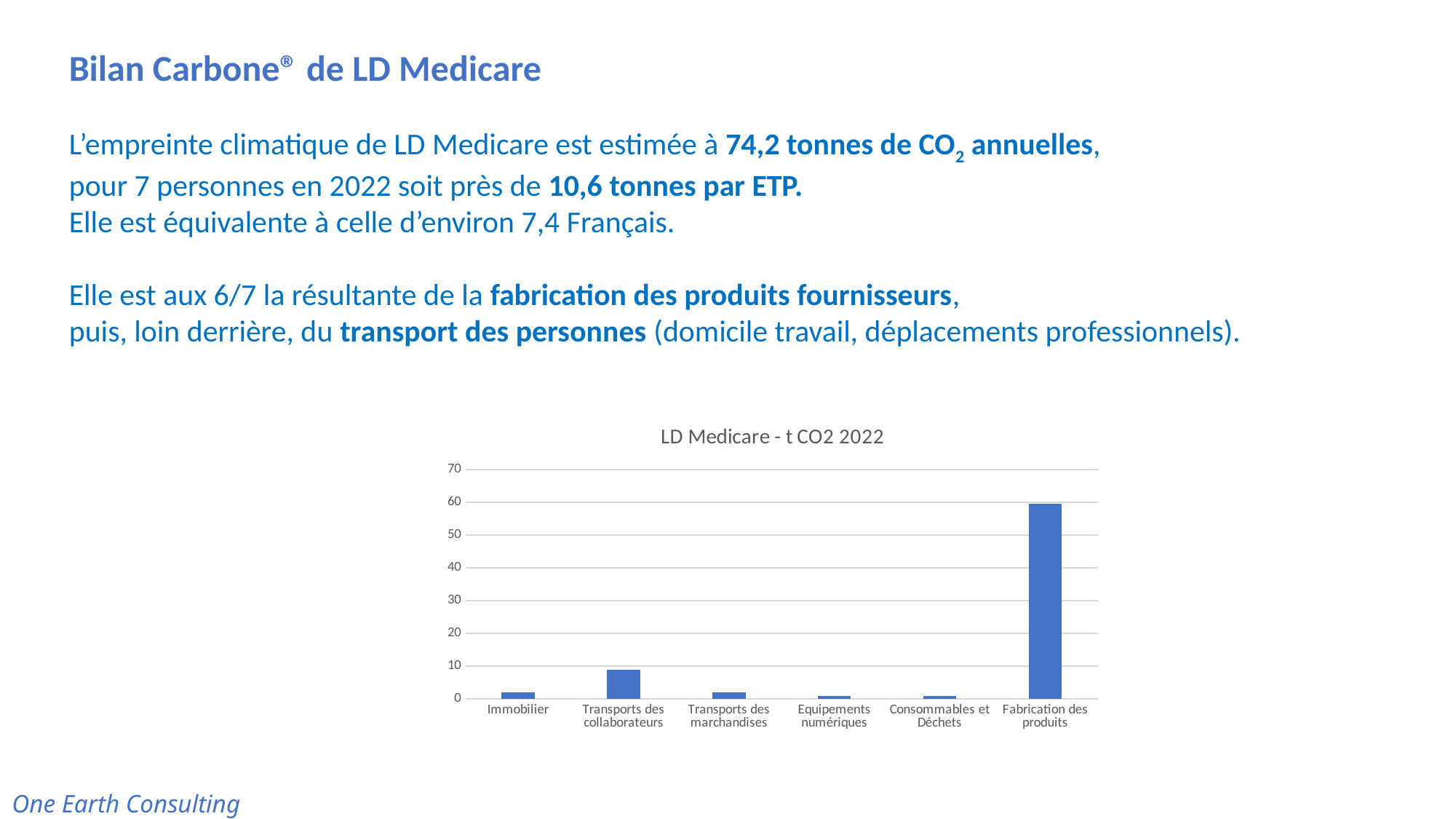
What kind of chart is shown on the slide? bar chart What is the title of the chart? LD Medicare - t CO2 2022 Is the value for Fabrication des produits greater or less than 70? less Which is larger, the value for Transports des collaborateurs or the value for Equipements numériques? Transports des collaborateurs Which is larger, the value for Fabrication des produits or the value for Transports des marchandises? Fabrication des produits Which category has the highest value in the chart? Fabrication des produits How many categories are shown on the x axis of the chart? 6 Is the value for Fabrication des produits greater or less than 50? greater What is the highest tick value shown on the y axis of the chart? 70 Is the value for Immobilier greater or less than 10? less Which is larger, the value for Transports des collaborateurs or the value for Immobilier? Transports des collaborateurs